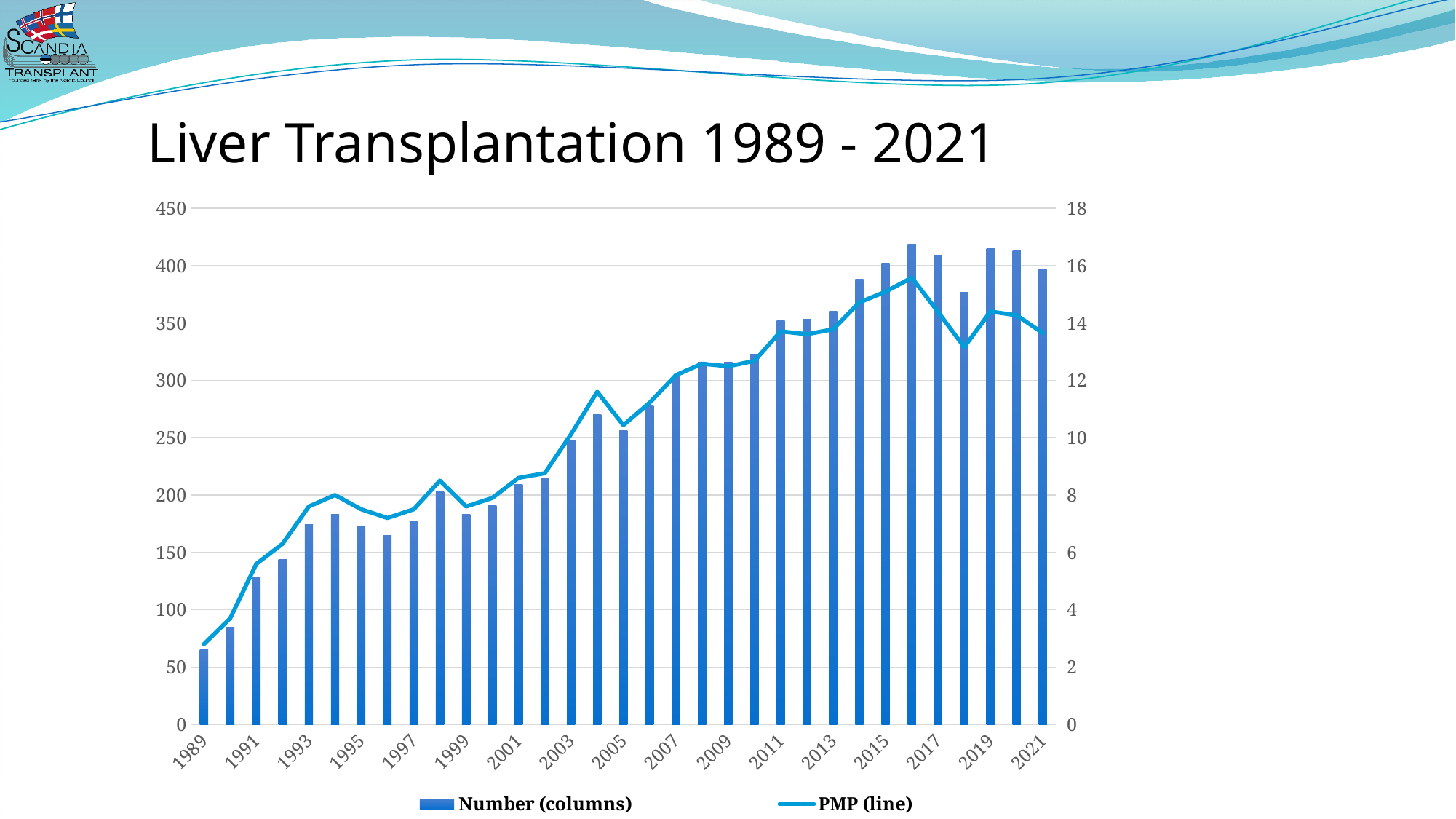
Is the number of liver transplantations in 1989 greater or less than 100? less How many years (bars) are plotted on the chart? 33 Which year has the higher number of liver transplantations, 2018 or 2019? 2019 Is the number of liver transplantations in 2018 greater or less than 400? less How many series does the legend list? 2 Overall, does the number of liver transplantations rise or fall from 1989 to 2021? rise What are the two series named in the legend? Number (columns) and PMP (line) What kind of chart is shown on the slide? Combined bar and line chart Which year has the lowest number of liver transplantations (shortest bar)? 1989 Is the PMP value in 2016 greater or less than 14? greater